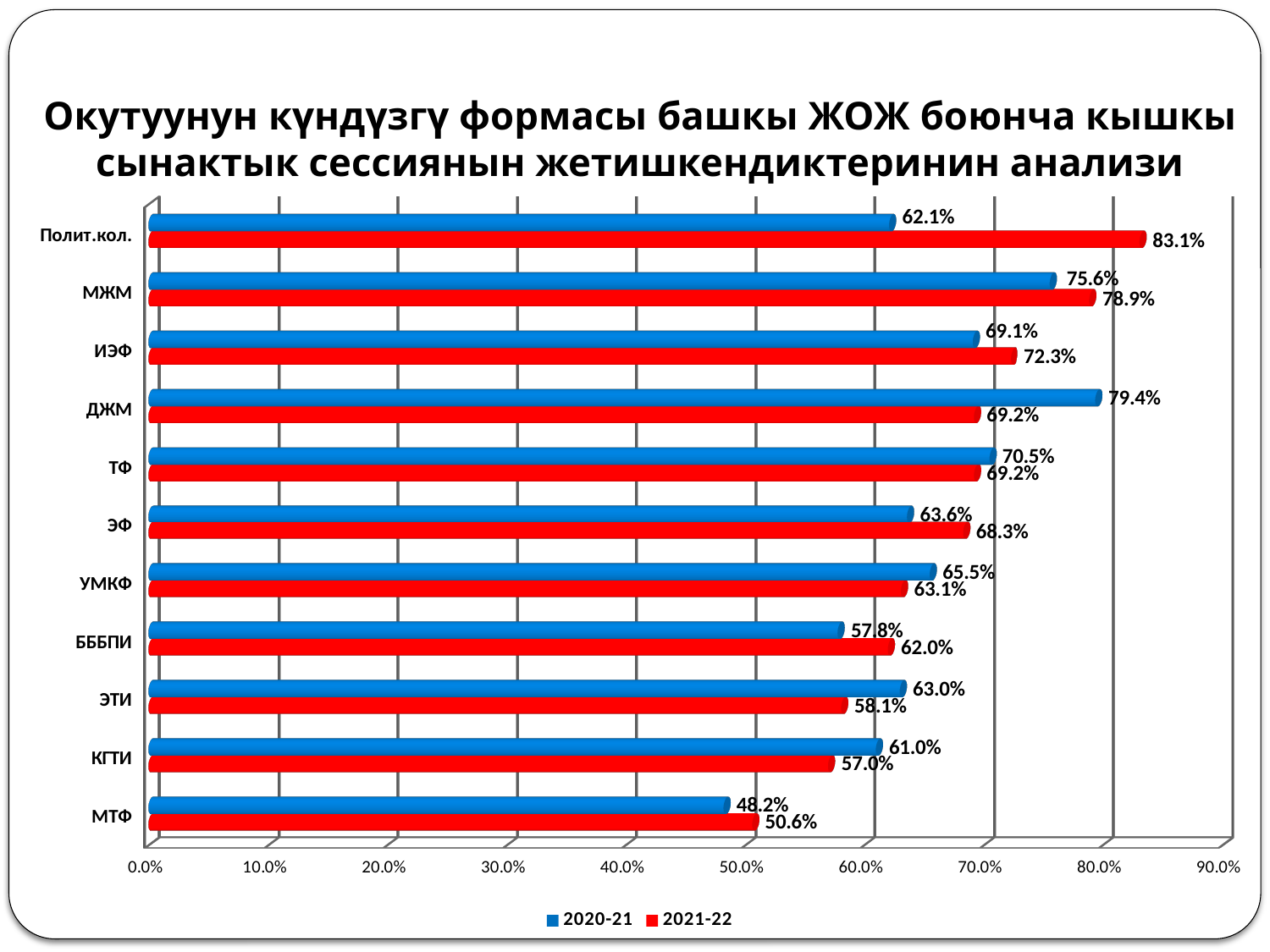
Which is larger for ДЖМ, the 2020-21 value or the 2021-22 value? 2020-21 How many categories are shown on the chart? 11 What is the 2021-22 value for Полит.кол.? 83.1% How many series does the legend list? 2 Which category has the lowest 2020-21 value? МТФ Which colour represents the 2021-22 series? red Is the 2020-21 value for МТФ greater or less than 50.0%? less What is the 2021-22 value for МТФ? 50.6% What type of chart is shown on the slide? bar chart What is the 2020-21 value for ДЖМ? 79.4% Which category has the highest 2021-22 value? Полит.кол. What is the difference between the 2021-22 and 2020-21 values for Полит.кол.? 21.0%